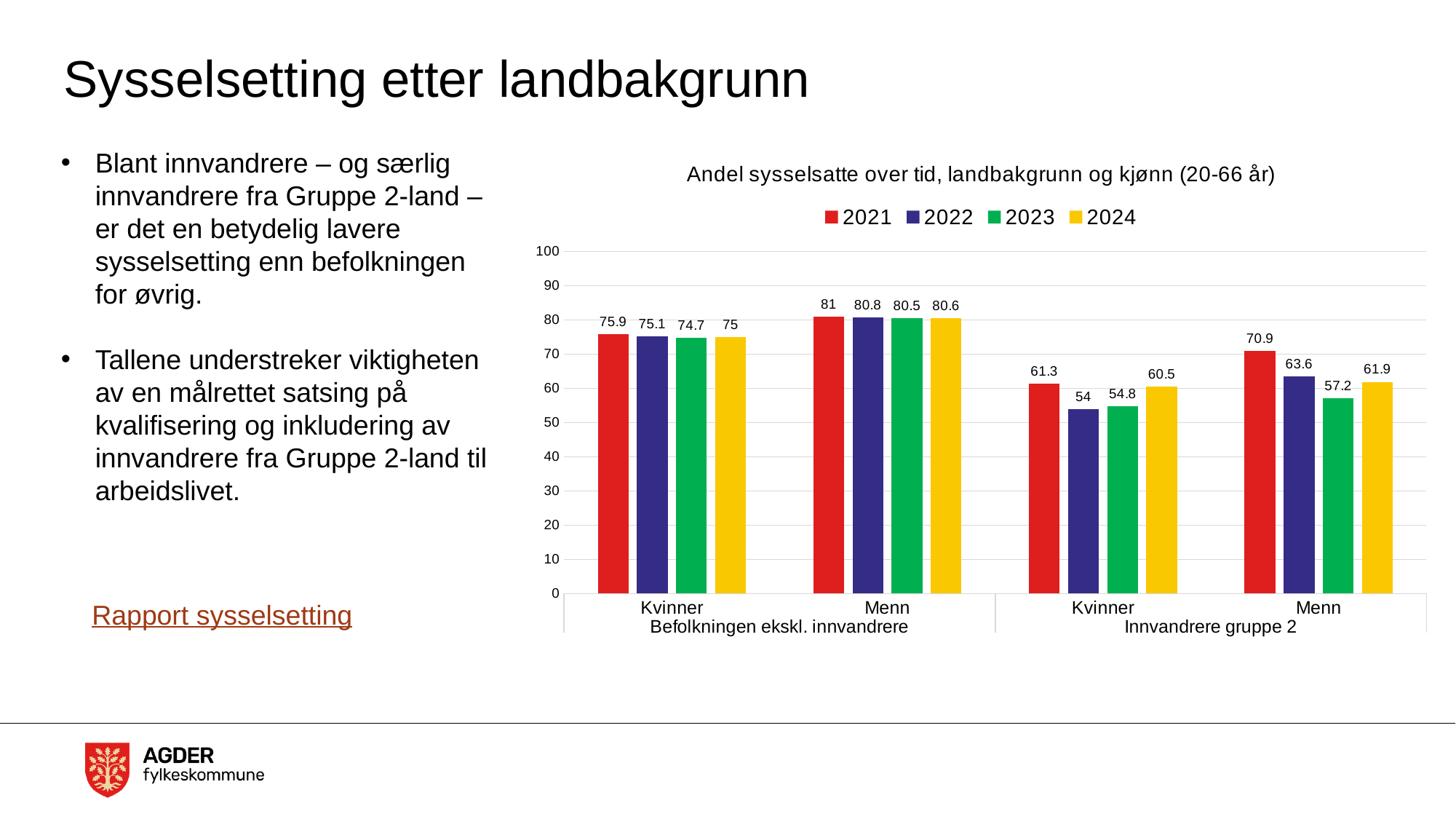
What is the 2021 value for Kvinner in the Innvandrere gruppe 2 group? 61.3 What is the 2023 value for Menn in the Befolkningen ekskl. innvandrere group? 80.5 What kind of chart is shown on the slide? bar chart Which year has the lowest value for Kvinner in the Innvandrere gruppe 2 group? 2022 Which is larger: the 2024 value for Kvinner in Befolkningen ekskl. innvandrere or the 2024 value for Kvinner in Innvandrere gruppe 2? Kvinner in Befolkningen ekskl. innvandrere What is the 2024 value for Menn in the Innvandrere gruppe 2 group? 61.9 Is the 2022 value for Kvinner in the Innvandrere gruppe 2 group greater or less than 60? less Which year has the highest value for Menn in the Innvandrere gruppe 2 group? 2021 Do the values for Menn in the Befolkningen ekskl. innvandrere group rise or fall from 2021 to 2023? fall How many series does the legend list? 4 What is the difference between the 2021 and 2023 values for Menn in the Innvandrere gruppe 2 group? 13.7 What is the title of the chart? Andel sysselsatte over tid, landbakgrunn og kjønn (20-66 år)